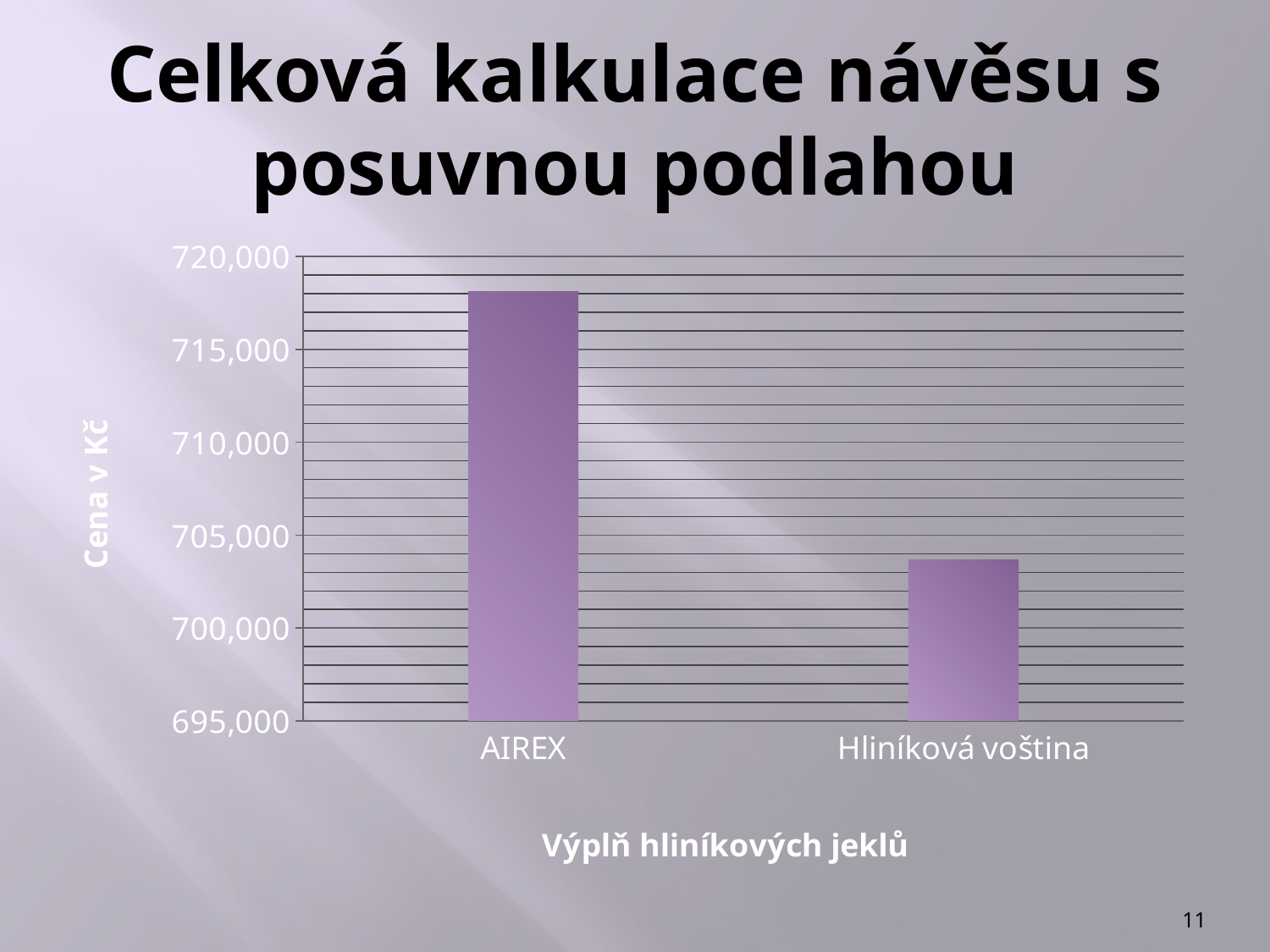
Which category has the highest value in the chart? AIREX What is the title of the horizontal axis of the chart? Výplň hliníkových jeklů Is the value for Hliníková voština greater or less than 700,000? greater Which category has the lowest value in the chart? Hliníková voština What kind of chart is shown on the slide? bar chart Is the value for AIREX greater or less than 720,000? less Is the value for Hliníková voština greater or less than 705,000? less What is the title of the vertical axis of the chart? Cena v Kč Which is larger, the value for AIREX or the value for Hliníková voština? AIREX How many categories are plotted on the x axis of the chart? 2